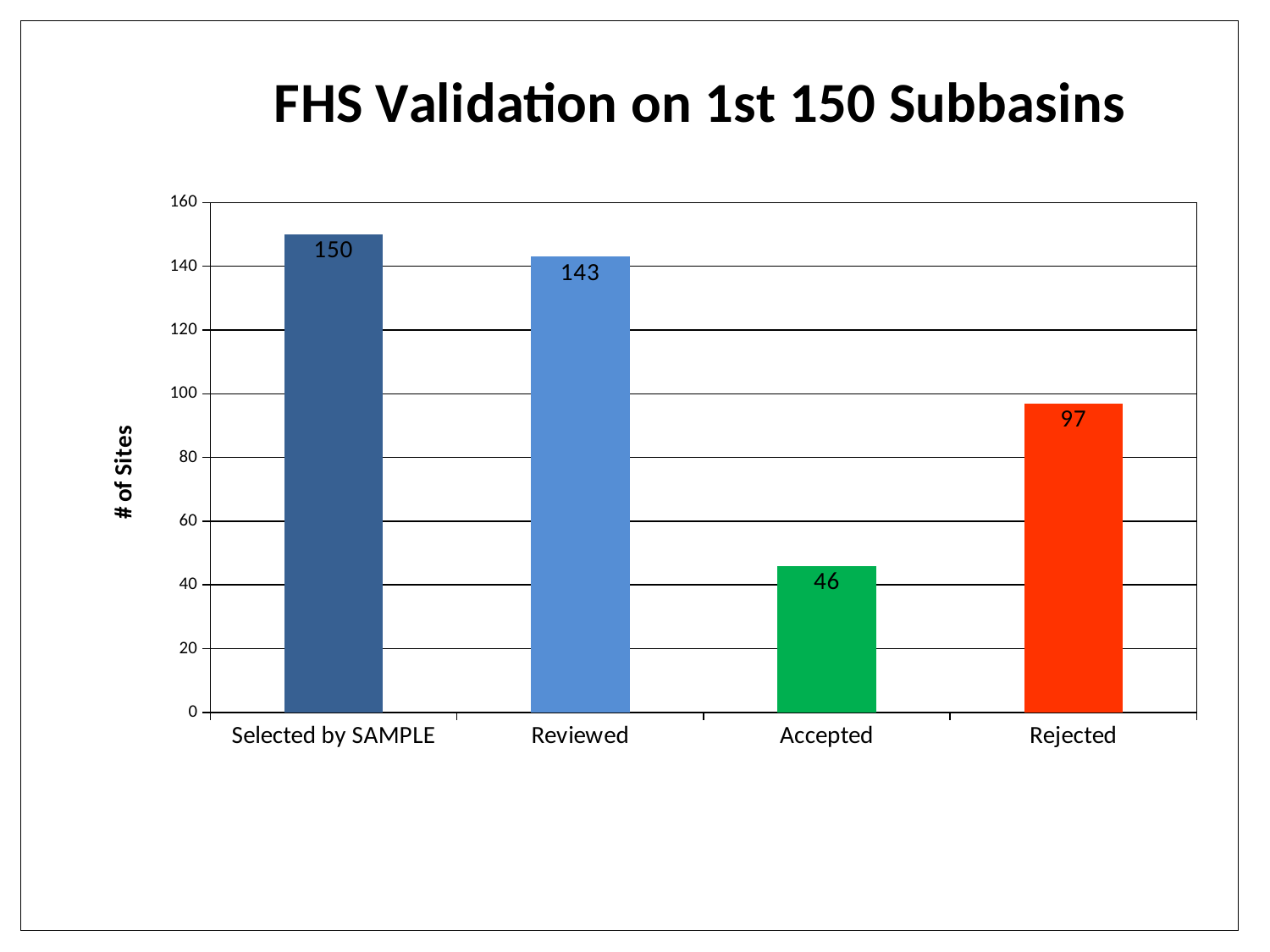
What is the value for Rejected? 97 What is the difference between the Rejected and Accepted values? 51 What is the difference between the Selected by SAMPLE and Reviewed values? 7 What is the value for Selected by SAMPLE? 150 How many categories are shown on the x axis? 4 What is the value for Accepted? 46 Which category has the lowest value? Accepted What kind of chart is this? Bar chart What is the value for Reviewed? 143 Which category has the highest value? Selected by SAMPLE Which is larger, the value for Rejected or the value for Accepted? Rejected What is the title of the chart? FHS Validation on 1st 150 Subbasins